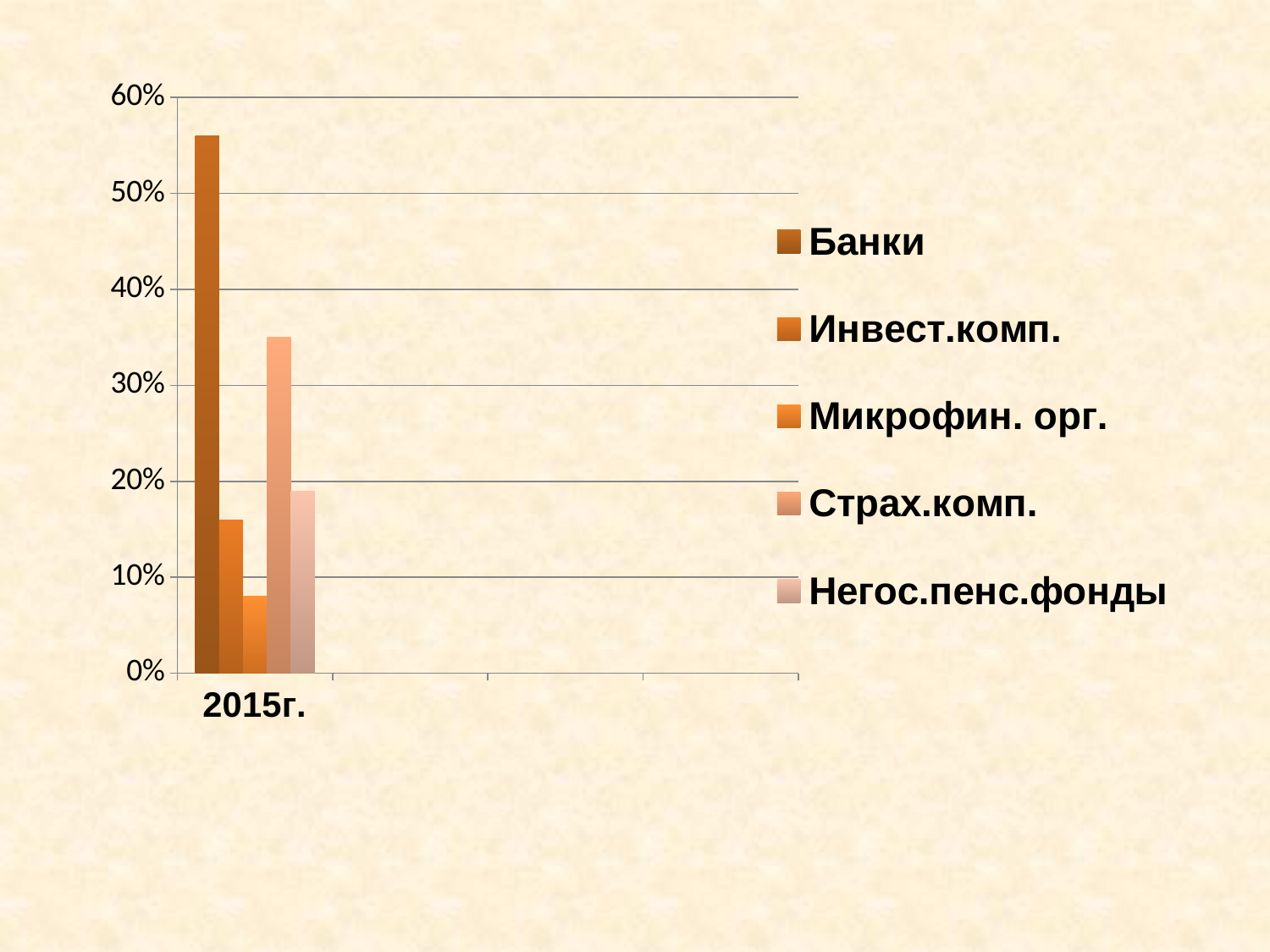
What kind of chart is shown on the slide? bar chart Is the value for Инвест.комп. in 2015г. greater or less than 20%? less Is the value for Негос.пенс.фонды in 2015г. greater or less than 10%? greater What is the label of the category on the x axis? 2015г. How many series does the legend list? 5 Is the value for Страх.комп. in 2015г. greater or less than 30%? greater Which series has the lowest value for 2015г.? Микрофин. орг. Which is larger in 2015г., Страх.комп. or Инвест.комп.? Страх.комп. How many categories are shown on the x axis? 1 Which series has the highest value for 2015г.? Банки